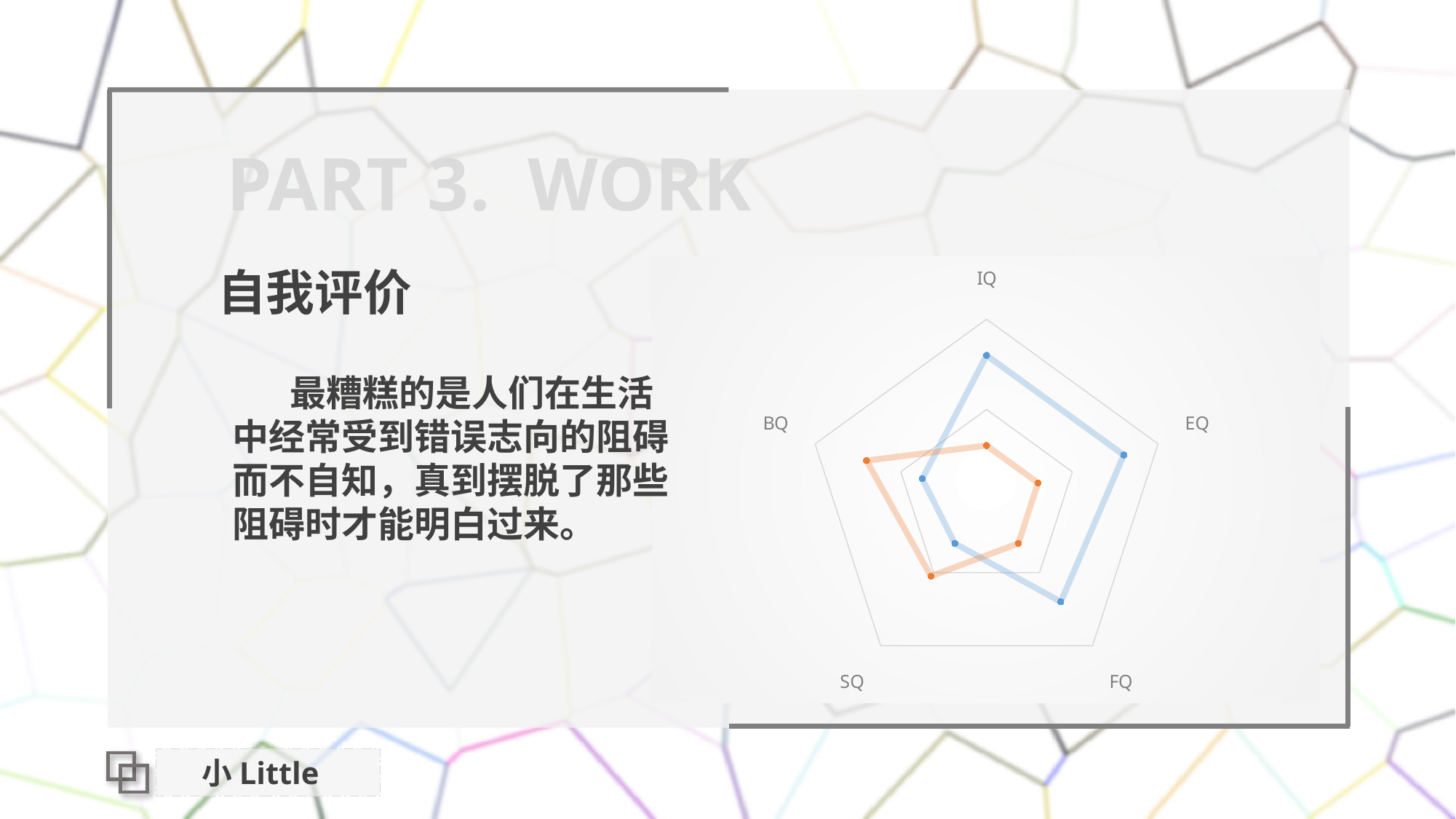
On the SQ axis, which series has the larger value, the blue one or the orange one? orange How many data series are plotted on the radar chart? 2 On the EQ axis, which series has the larger value, the blue one or the orange one? blue On the FQ axis, which series has the larger value, the blue one or the orange one? blue Which axis label appears at the top of the radar chart? IQ How many categories (axes) does the radar chart have? 5 What kind of chart is shown on the slide? radar chart What two colours are used for the series on the radar chart? blue and orange